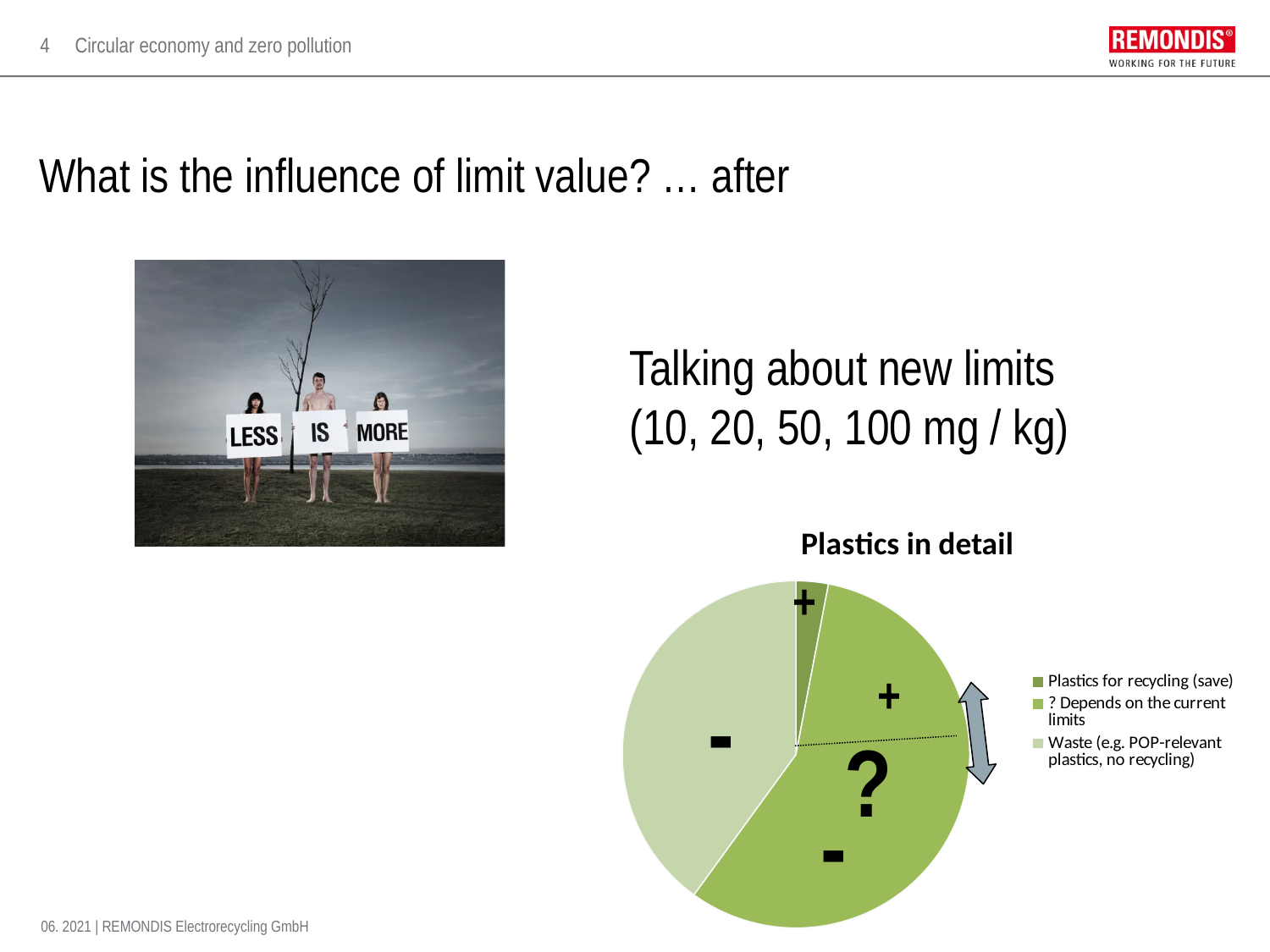
Which category has the largest slice in the pie chart? ? Depends on the current limits Which legend entry is shown with the lightest green colour in the pie chart? Waste (e.g. POP-relevant plastics, no recycling) How many entries does the legend of the pie chart list? 3 Which category has the smallest slice in the pie chart? Plastics for recycling (save) What is the title of the pie chart? Plastics in detail What kind of chart is shown on the slide? pie chart How many slices does the pie chart have? 3 Which slice is larger: "Waste (e.g. POP-relevant plastics, no recycling)" or "Plastics for recycling (save)"? Waste (e.g. POP-relevant plastics, no recycling) Which slice is larger: "? Depends on the current limits" or "Plastics for recycling (save)"? ? Depends on the current limits